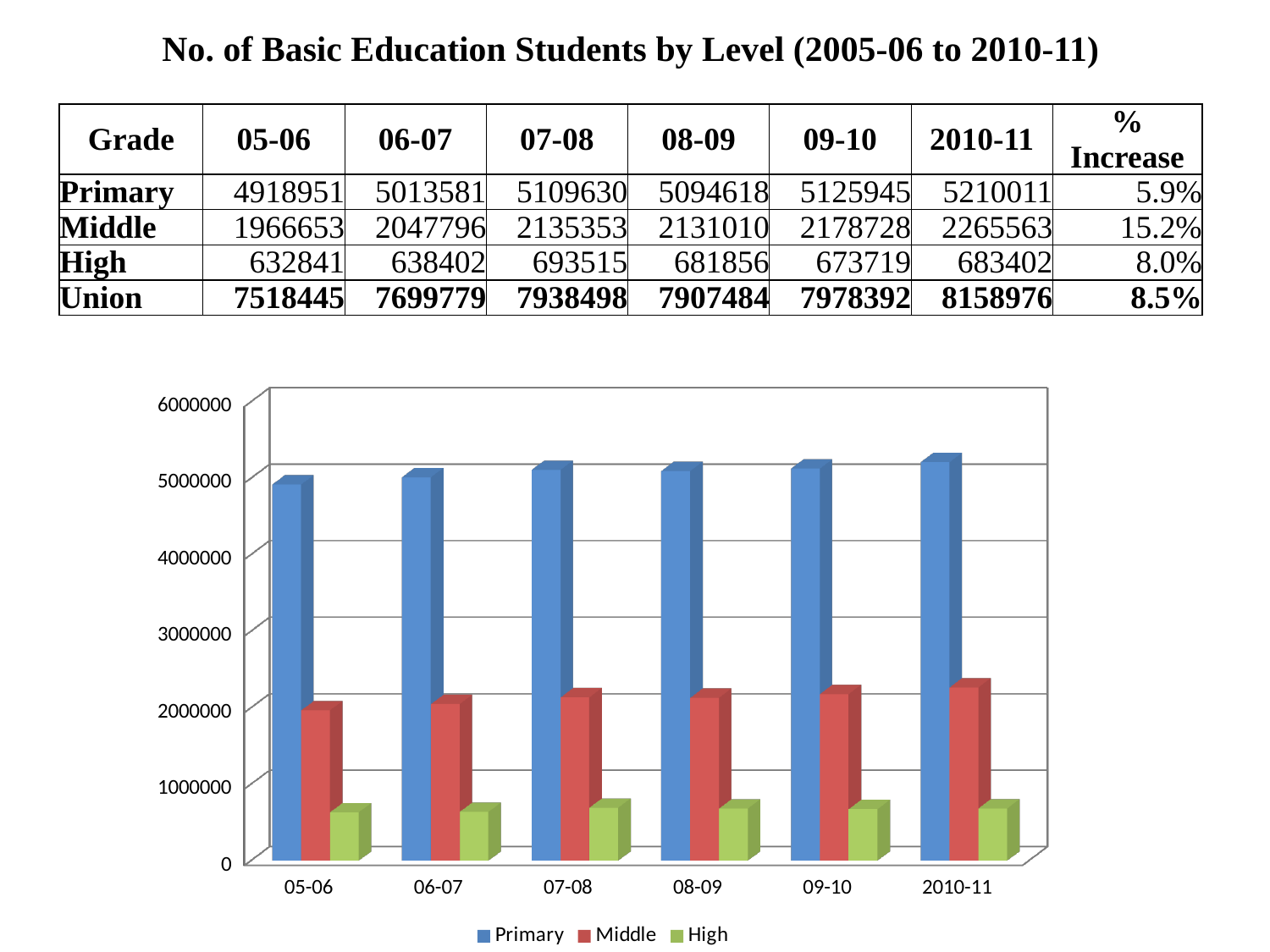
How many school-year categories are shown on the x axis of the chart? 6 What is the number of Primary students in 2010-11? 5210011 What is the difference between the Primary values for 2010-11 and 05-06? 291060 How many series does the chart legend list? 3 What kind of chart is shown on the slide? Bar chart In which year is the Primary series highest? 2010-11 What is the number of Middle students in 05-06? 1966653 Which is larger in 09-10, the Primary value or the Middle value? Primary Is the Primary value for 05-06 greater or less than 5000000? less What is the number of High students in 07-08? 693515 Which colour represents the Primary series in the chart? Blue In which year is the Primary series lowest? 05-06